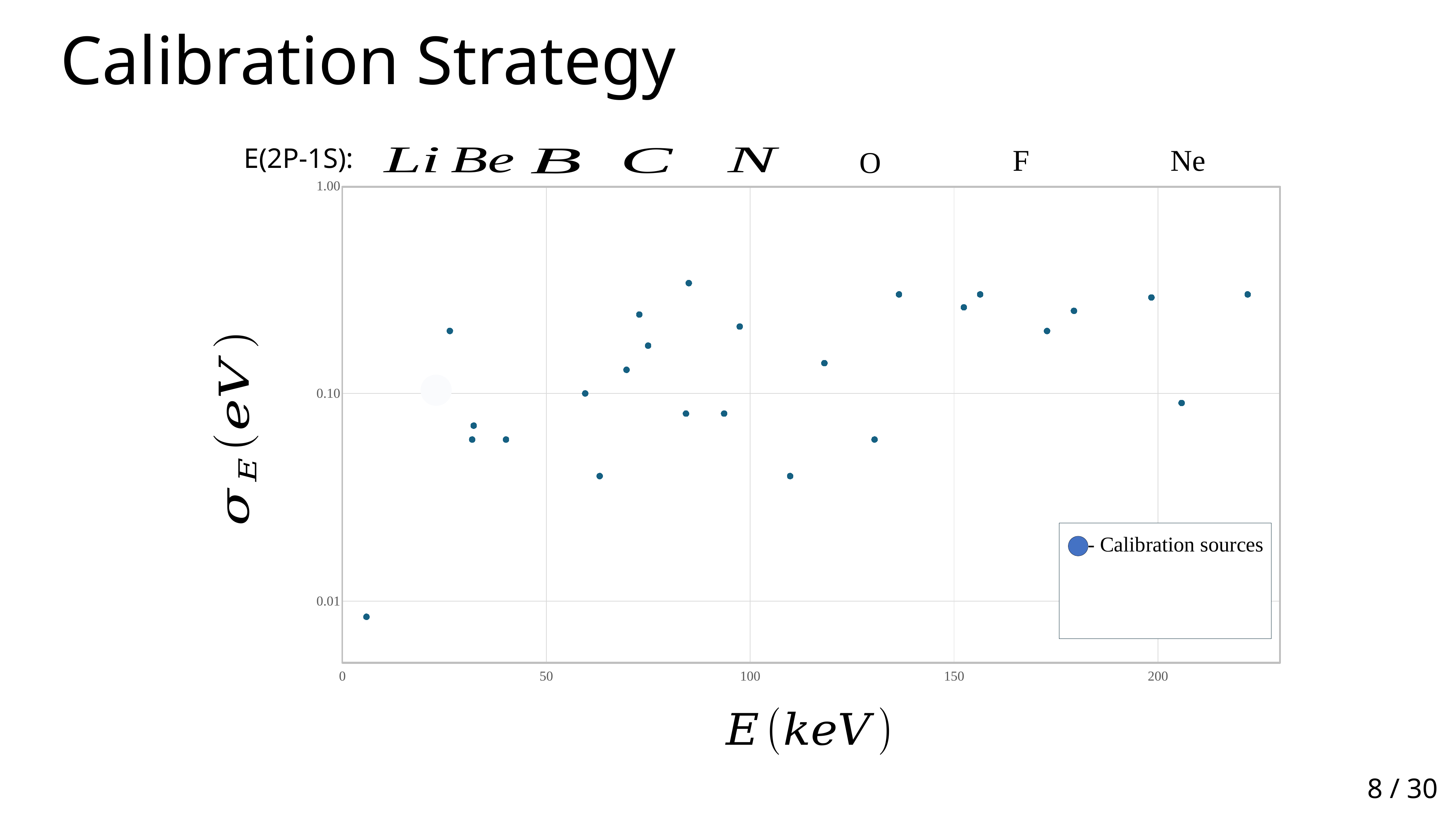
Is the highest σ_E value plotted greater or less than 1.00? less What is the label of the x axis? E (keV) Do the σ_E values generally rise or fall as E increases? rise Is the E value of the rightmost point greater or less than 200 keV? greater Is the E value of the point with the lowest σ_E greater or less than 50 keV? less What is the name of the series in the legend? Calibration sources What kind of chart is shown on the slide? scatter chart How many series does the legend list? 1